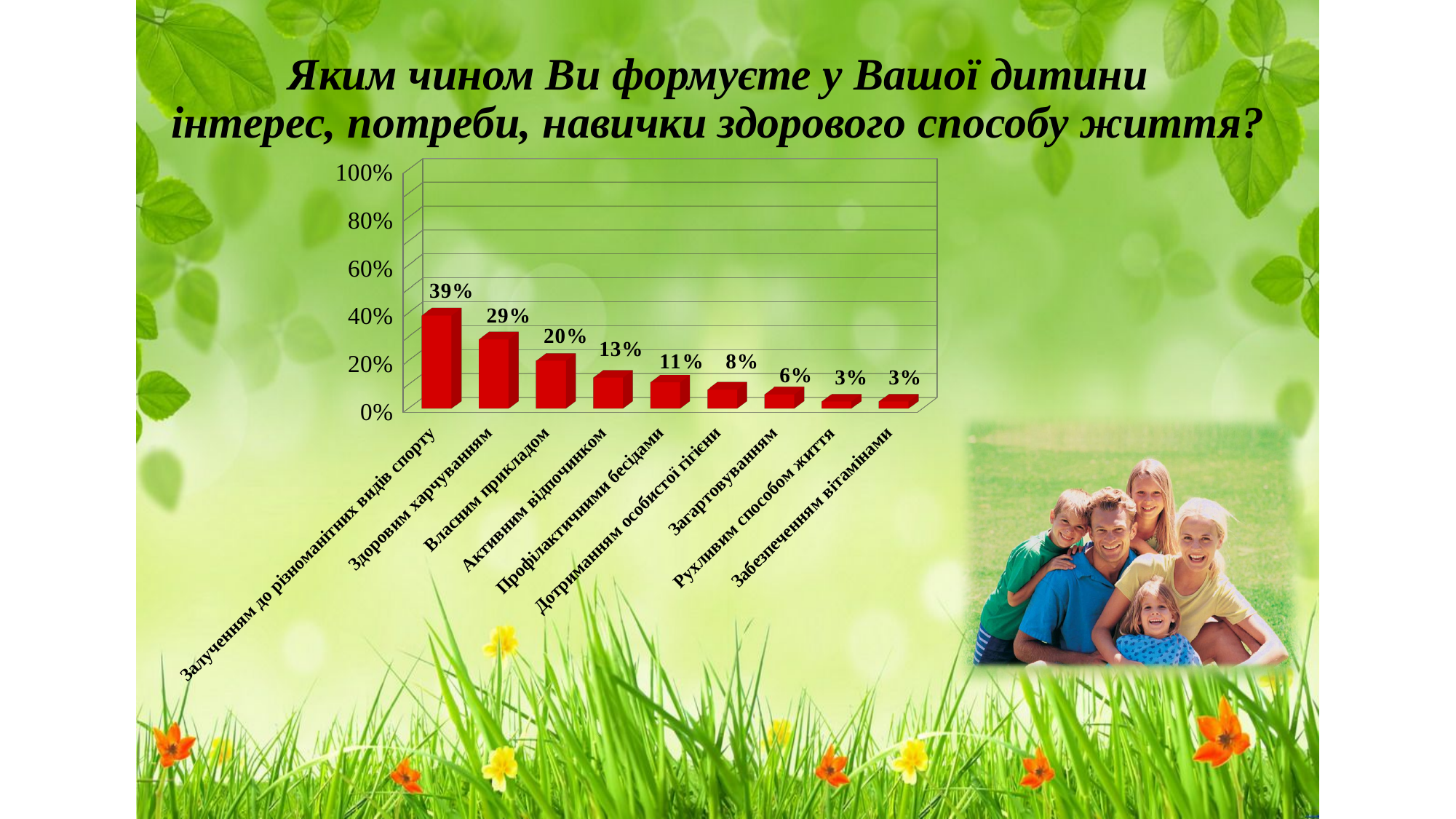
What value is shown for "Профілактичними бесідами"? 11% What is the difference between the values for "Залученням до різноманітних видів спорту" and "Здоровим харчуванням"? 10% How many categories are shown in the chart? 9 Which is larger, the value for "Власним прикладом" or the value for "Активним відпочинком"? Власним прикладом What kind of chart is shown on the slide? Bar chart Is the value for "Залученням до різноманітних видів спорту" greater or less than 20%? greater What value is shown for "Здоровим харчуванням"? 29% What value is shown for "Загартовуванням"? 6% Which category has the highest value? Залученням до різноманітних видів спорту Do the values rise or fall from left to right along the x axis? Fall What is the difference between the values for "Активним відпочинком" and "Дотриманням особистої гігієни"? 5% What value is shown for "Власним прикладом"? 20%